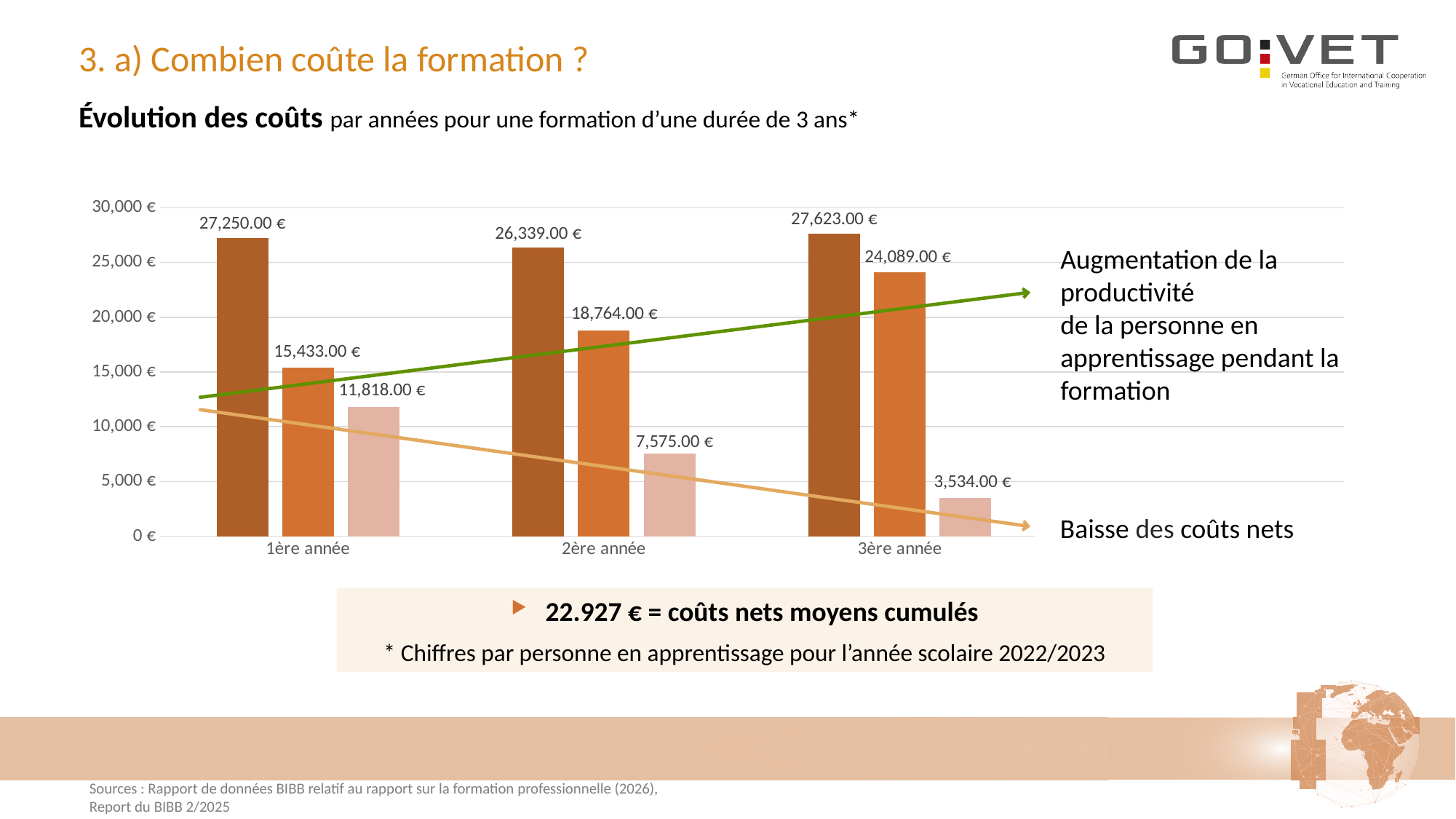
Which is larger: the orange bar for 2ère année or the orange bar for 3ère année? 3ère année What is the value of the orange (middle) bar for 2ère année? 18,764.00 € What is the value of the light pink (third) bar for 3ère année? 3,534.00 € Which year has the lowest value for the light pink (third) bar? 3ère année What is the highest value shown on the y axis? 30,000 € Do the values of the light pink (third) bars rise or fall from 1ère année to 3ère année? Fall What is the difference between the dark brown bar and the orange bar for 1ère année? 11,817.00 € What is the value of the dark brown (first) bar for 1ère année? 27,250.00 € What is the difference between the orange bar and the light pink bar for 3ère année? 20,555.00 € What kind of chart is shown on the slide? Bar chart How many year categories are shown on the x axis? 3 Which year has the highest value for the dark brown (first) bar? 3ère année